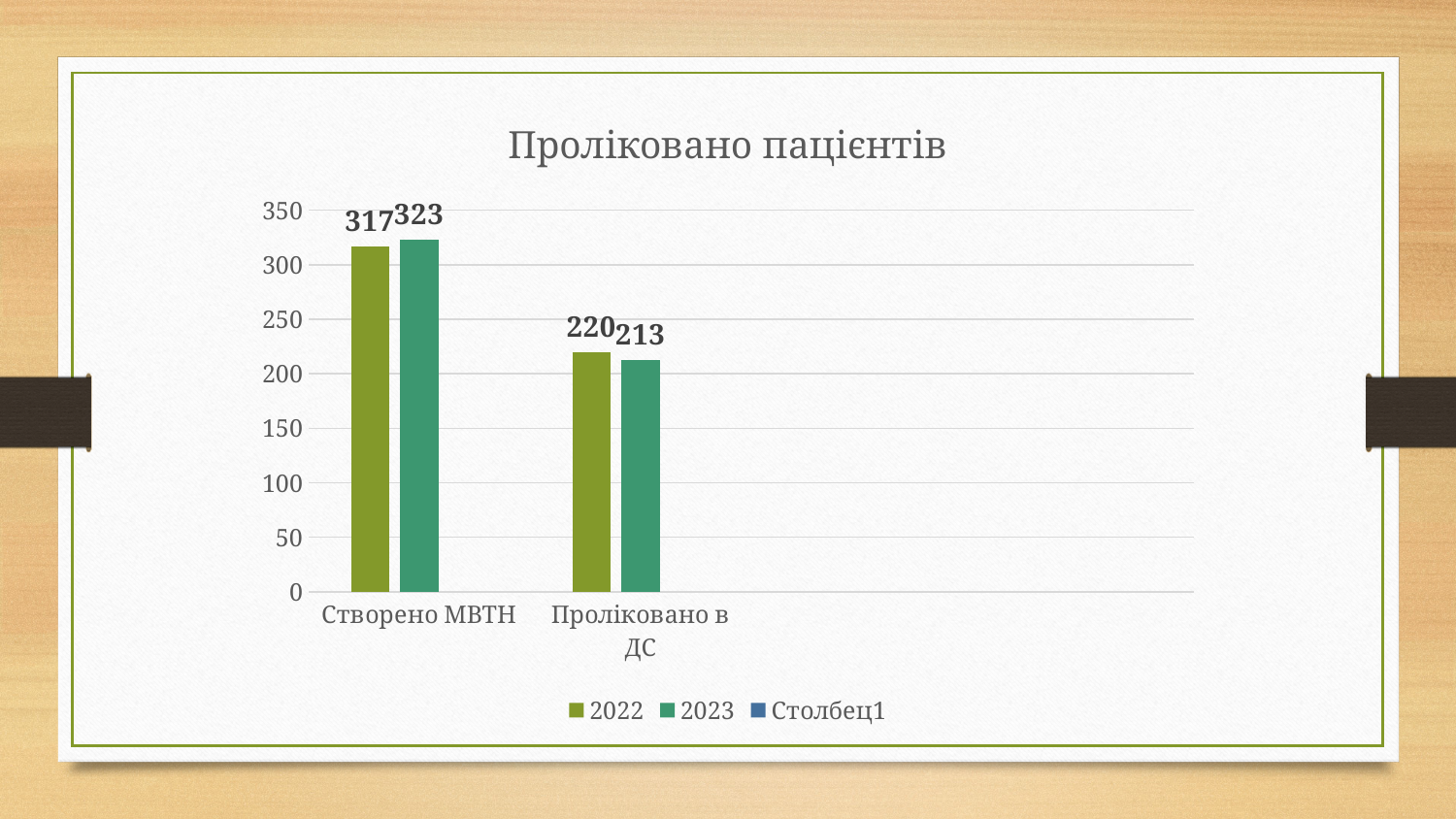
What is the value for 2022 in the 'Створено МВТН' category? 317 How many categories are shown on the x axis? 2 What is the value for 2023 in the 'Створено МВТН' category? 323 Which category has the lowest value for the 2022 series? Проліковано в ДС What is the value for 2022 in the 'Проліковано в ДС' category? 220 What is the value for 2023 in the 'Проліковано в ДС' category? 213 What is the difference between the 2023 and 2022 values for 'Створено МВТН'? 6 What is the title of the chart? Проліковано пацієнтів Which category has the highest value for the 2023 series? Створено МВТН Which is larger for 'Проліковано в ДС': the 2022 value or the 2023 value? 2022 How many series does the legend list? 3 What is the difference between the 2022 and 2023 values for 'Проліковано в ДС'? 7